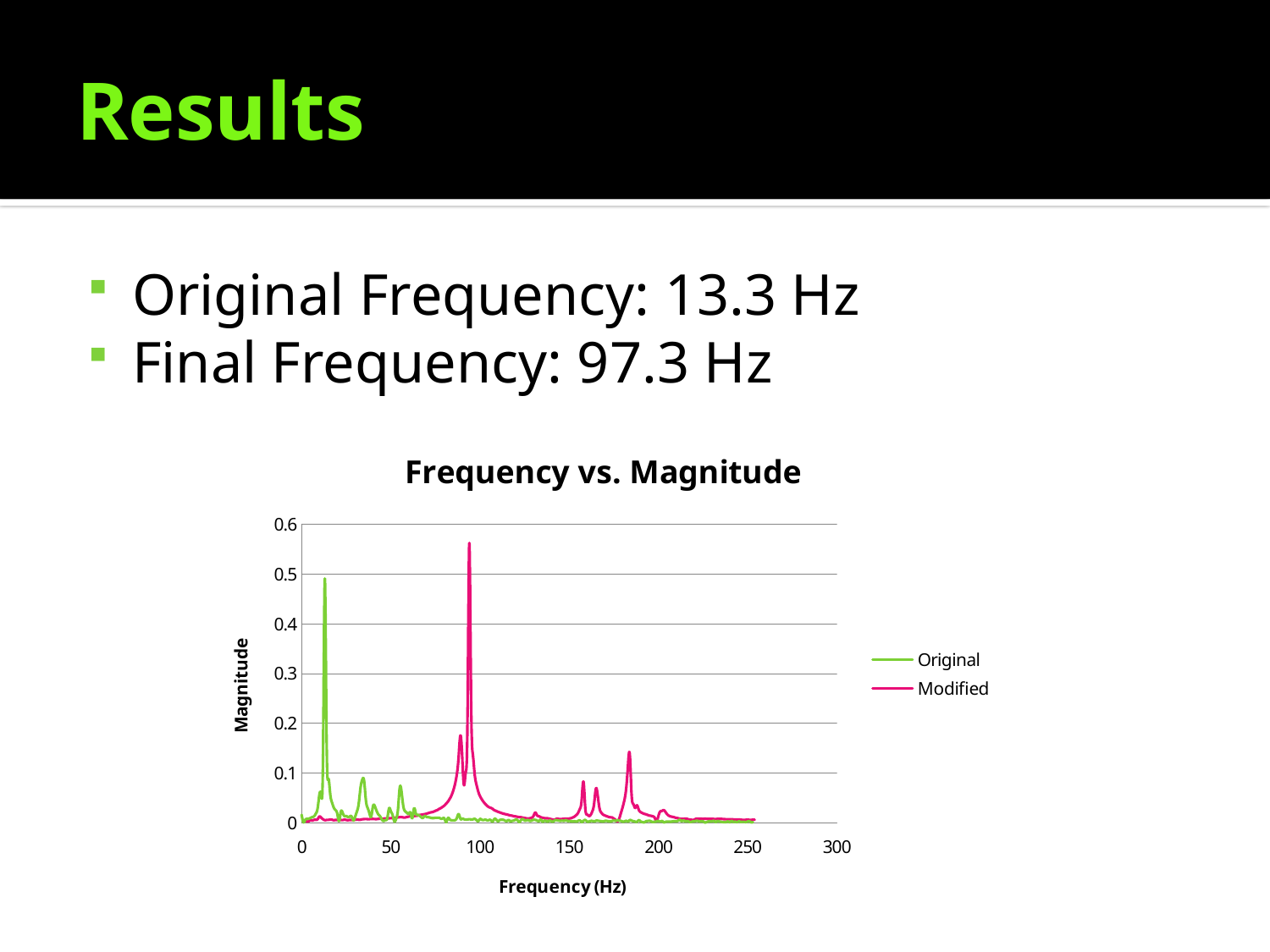
Does the highest peak of the Original series occur at a frequency greater or less than 50 Hz? less How many series does the chart's legend list? 2 Is the peak magnitude of the Original series greater or less than 0.6? less What is the title of the chart? Frequency vs. Magnitude What type of chart is shown on the slide? line chart Is the peak magnitude of the Original series greater or less than 0.4? greater Which series has its main peak at the higher frequency, Original or Modified? Modified What is the maximum value shown on the chart's y axis (Magnitude)? 0.6 What are the two series named in the chart's legend? Original and Modified Which series reaches the higher peak magnitude, Original or Modified? Modified